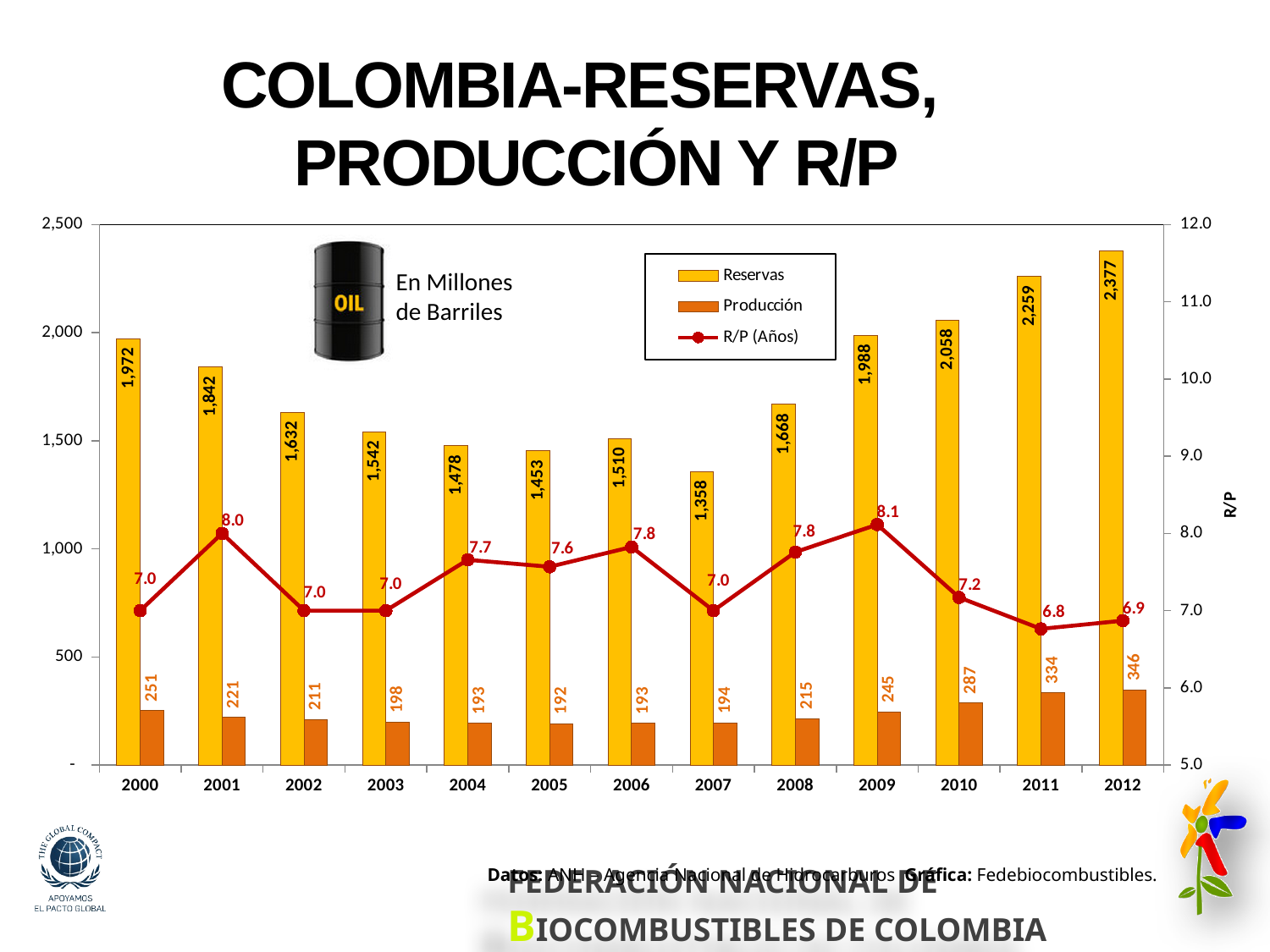
What is the difference between Reservas in 2012 and Reservas in 2011? 118 Which is larger, Producción in 2010 or Producción in 2009? Producción in 2010 Which year has the lowest Reservas value? 2007 Which year has the lowest R/P (Años) value? 2011 What is the value of Reservas for 2012? 2,377 What unit is stated for the bar values on the chart? En Millones de Barriles Which year has the highest Producción value? 2012 How many series does the legend list? 3 What is the value of Producción for 2000? 251 How many years are shown on the x axis? 13 Do the Reservas values rise or fall from 2007 to 2012? rise What is the R/P (Años) value for 2009? 8.1